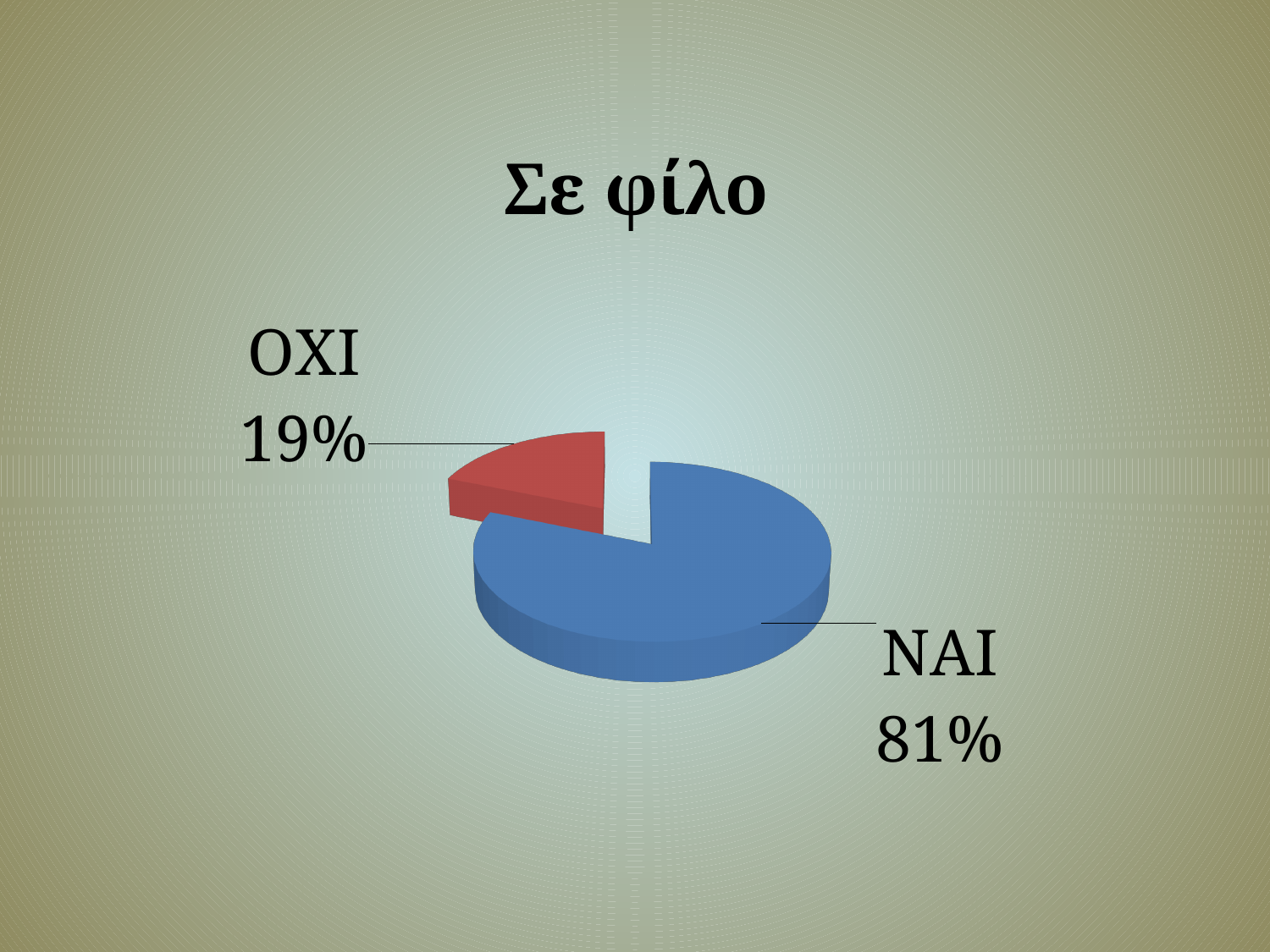
Which slice is the largest? ΝΑΙ What percentage does the ΝΑΙ slice represent? 81% How many slices does the pie chart have? 2 What share of the pie does ΝΑΙ take? 81% What is the difference in percentage points between ΝΑΙ and ΟΧΙ? 62 What colour is the ΟΧΙ slice? red Which slice is the smallest? ΟΧΙ Which is larger, ΝΑΙ or ΟΧΙ? ΝΑΙ What kind of chart is shown on the slide? pie chart What percentage does the ΟΧΙ slice represent? 19% What is the title of the chart? Σε φίλο